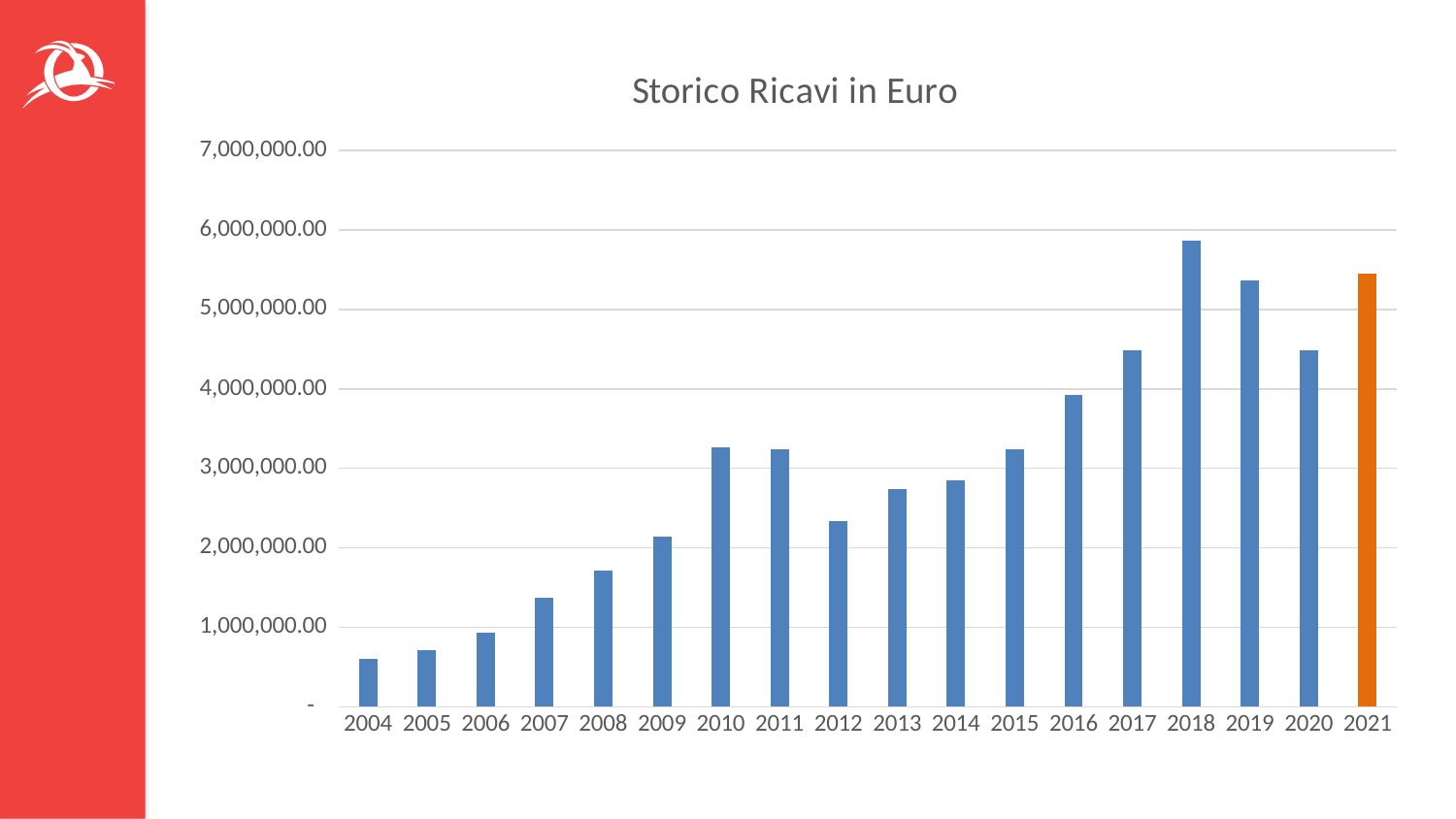
Is the value for 2012 greater or less than 2,000,000.00? greater Which bar is shown in a different colour (orange) from the others? 2021 Which year has the lowest value in the chart? 2004 What is the title of the chart? Storico Ricavi in Euro How many years are shown on the x axis of the chart? 18 Which is larger, the value for 2021 or the value for 2020? 2021 What kind of chart is shown on the slide? Bar chart Is the value for 2018 greater or less than 5,000,000.00? greater Is the value for 2016 greater or less than 4,000,000.00? less Which year has the highest value in the chart? 2018 Which is larger, the value for 2018 or the value for 2019? 2018